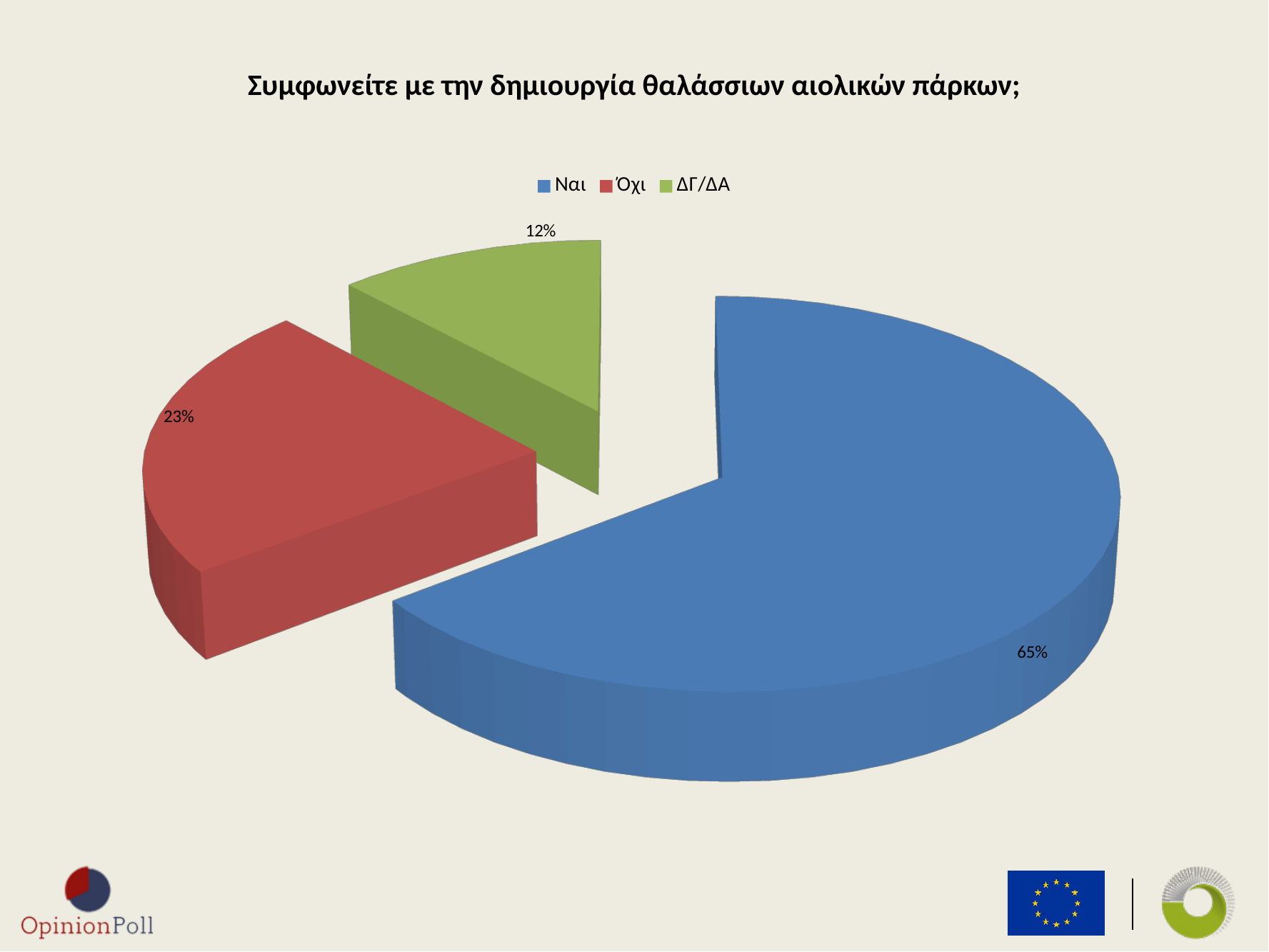
Which response has the smallest share of the pie? ΔΓ/ΔΑ What percentage of respondents answered Ναι? 65% What percentage of respondents answered ΔΓ/ΔΑ? 12% What percentage of respondents answered Όχι? 23% Which response has the largest share of the pie? Ναι What kind of chart is shown on the slide? Pie chart What colour is the slice for Όχι? Red What is the difference in percentage points between Όχι and ΔΓ/ΔΑ? 11 Which is larger, the share for Όχι or the share for ΔΓ/ΔΑ? Όχι How many entries does the legend list? 3 What is the difference in percentage points between Ναι and Όχι? 42 How many slices does the pie chart have? 3